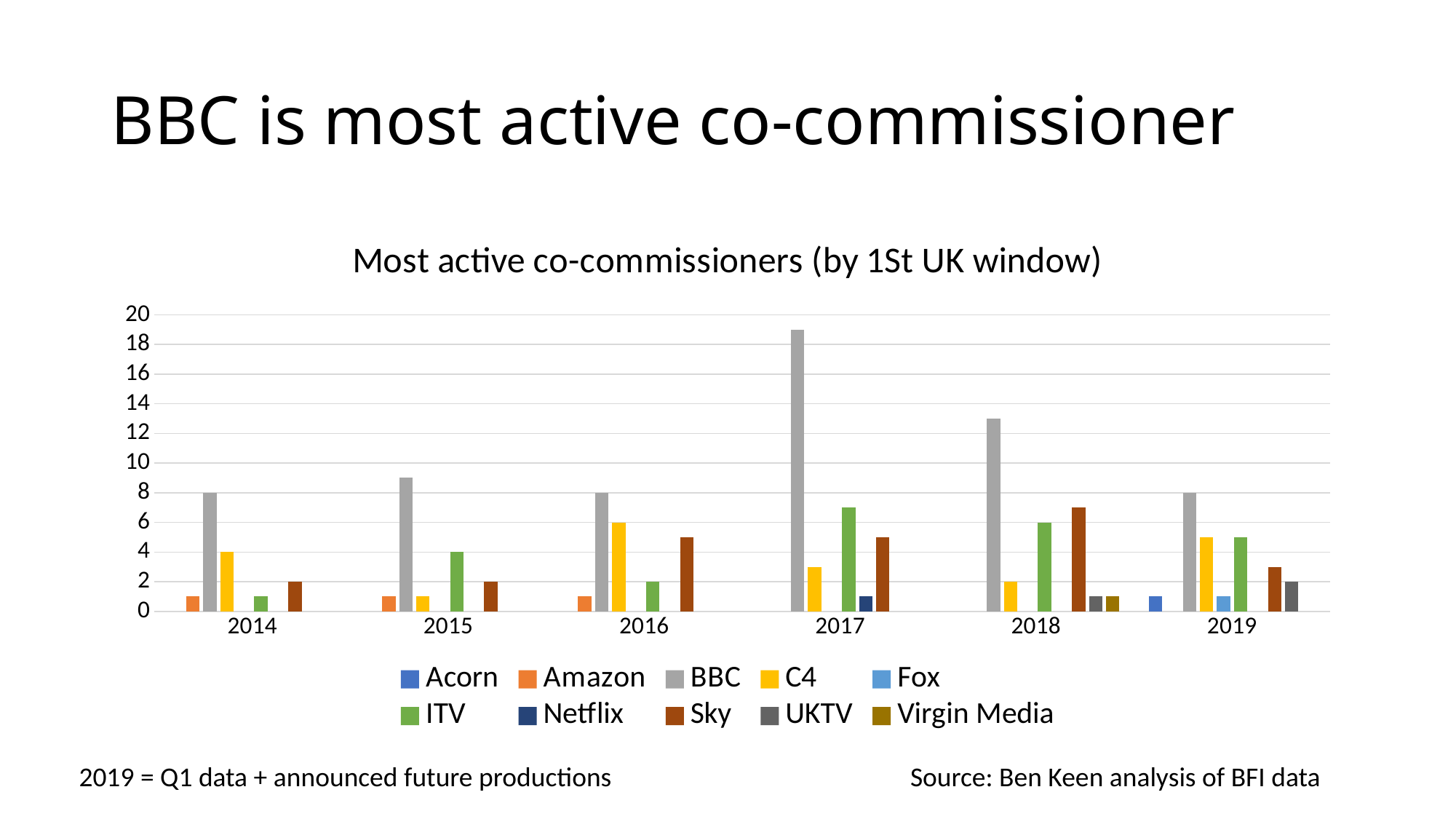
What is the difference between the BBC value and the C4 value in 2016? 2 What is the title of the chart? Most active co-commissioners (by 1St UK window) In which year does BBC reach its highest value? 2017 What is the value for C4 in 2016? 6 Which is larger, the BBC value in 2017 or the BBC value in 2018? BBC in 2017 What is the value for ITV in 2018? 6 What is the value for BBC in 2014? 8 How many years are shown on the x axis? 6 How many series does the legend list? 10 Is the value for BBC in 2018 greater or less than 12? greater Is the value for BBC in 2017 greater or less than 18? greater What type of chart is shown on the slide? Bar chart